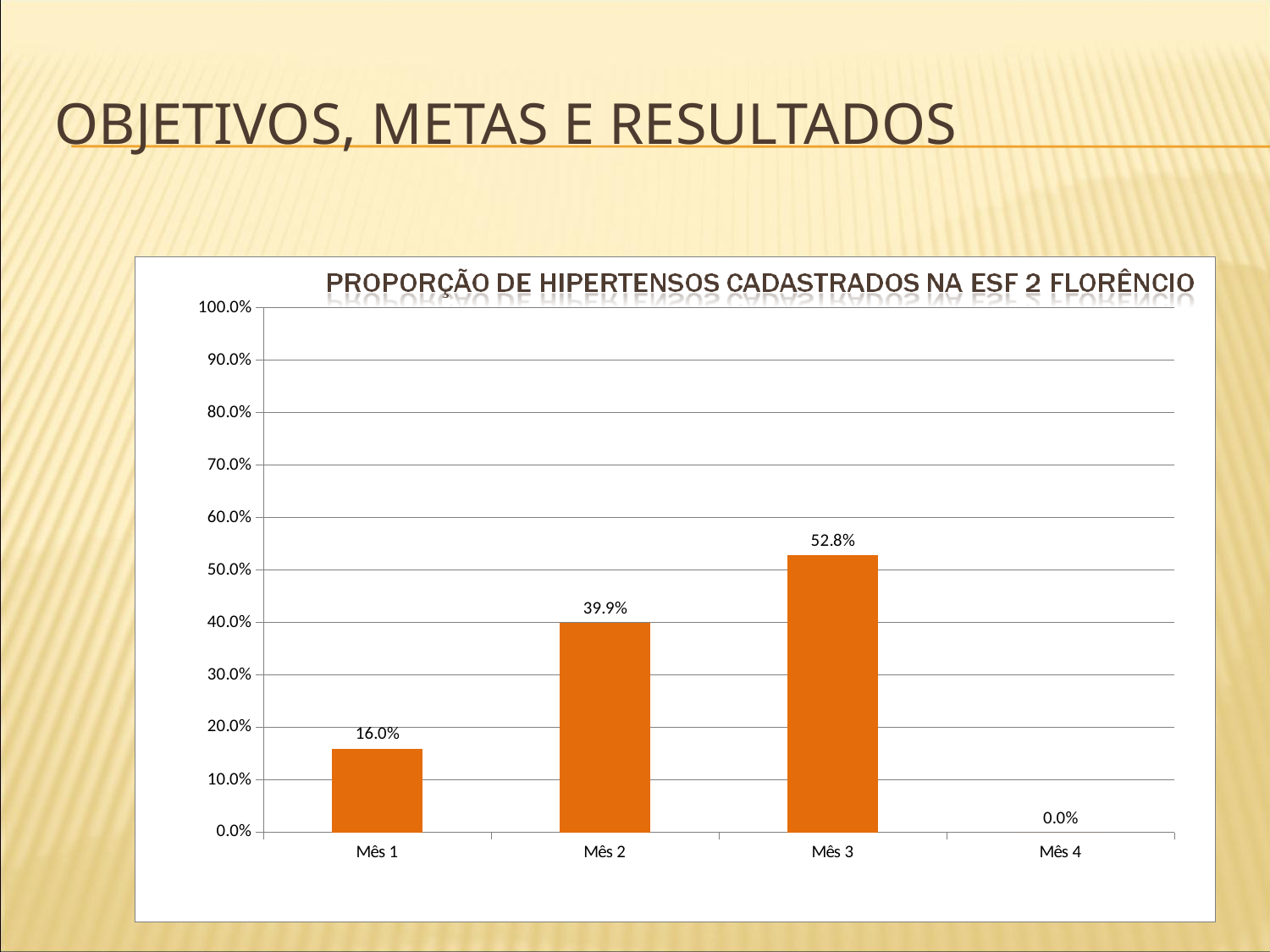
What kind of chart is shown on the slide? bar chart Which is larger, the value for Mês 1 or the value for Mês 2? Mês 2 What is the value for Mês 4? 0.0% What is the value for Mês 2? 39.9% What is the difference between the values for Mês 3 and Mês 2? 12.9% Which month has the highest value? Mês 3 What is the title of the chart? PROPORÇÃO DE HIPERTENSOS CADASTRADOS NA ESF 2 FLORÊNCIO What is the value for Mês 1? 16.0% What is the value for Mês 3? 52.8% Is the value for Mês 3 greater or less than 50.0%? greater How many months are shown on the x axis? 4 Which month has the lowest value? Mês 4